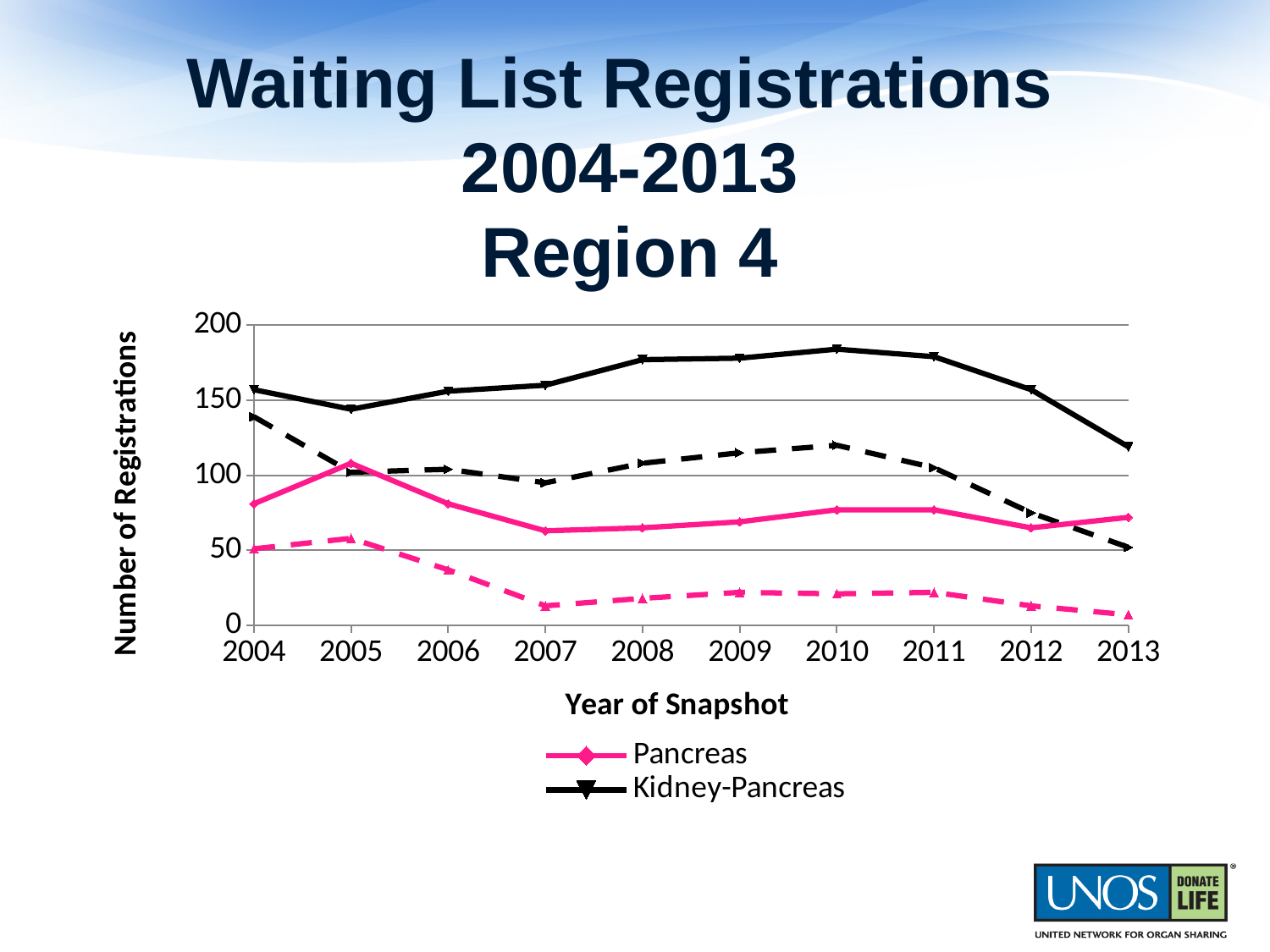
Is the Kidney-Pancreas value for 2010 greater or less than 150? greater Is the Pancreas value for 2005 greater or less than 100? greater What kind of chart is shown on the slide? line chart In which year is the Pancreas line at its highest? 2005 Is the Pancreas value for 2007 greater or less than 100? less In 2004, which series has the higher value, Pancreas or Kidney-Pancreas? Kidney-Pancreas How many series does the legend list? 2 What is the title of the x axis? Year of Snapshot In which year is the Kidney-Pancreas line at its lowest? 2013 Does the Kidney-Pancreas line rise or fall from 2010 to 2013? fall How many years are shown along the x axis? 10